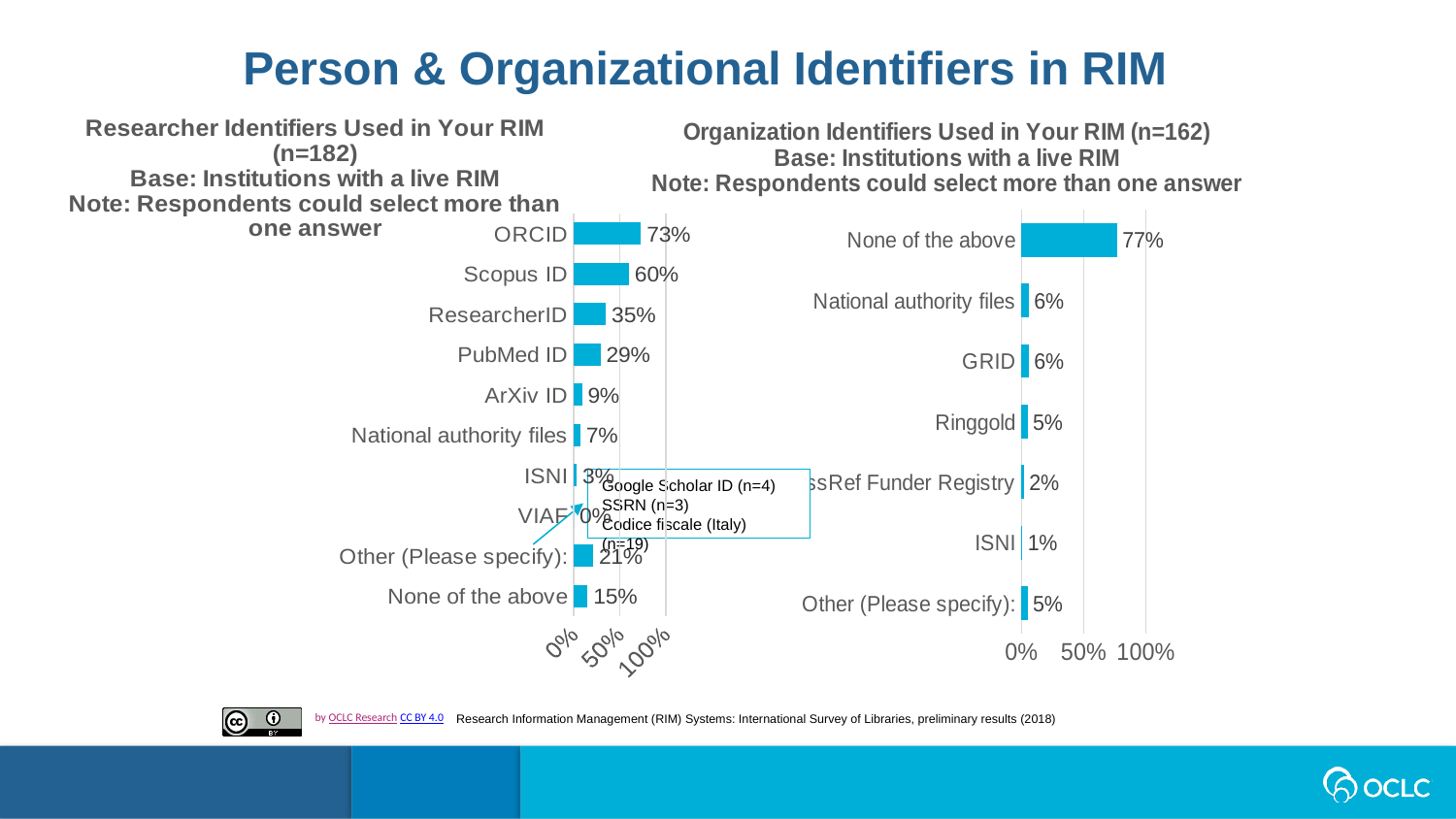
In the Researcher Identifiers chart, which is larger: PubMed ID or ArXiv ID? PubMed ID In the Researcher Identifiers chart, which category has the lowest value? VIAF In the Researcher Identifiers chart, what percentage of institutions use ORCID? 73% In the Researcher Identifiers chart, what is the value for Scopus ID? 60% In the Researcher Identifiers chart, which identifier has the highest percentage? ORCID In the Organization Identifiers chart, what percentage selected None of the above? 77% What type of chart is the Organization Identifiers chart? Bar chart In the Organization Identifiers chart, which category has the lowest value? ISNI In the Researcher Identifiers chart, what is the difference between ORCID and Scopus ID? 13% How many categories are shown in the Organization Identifiers chart? 7 In the Organization Identifiers chart, what is the value for Ringgold? 5% How many categories are shown in the Researcher Identifiers chart? 10